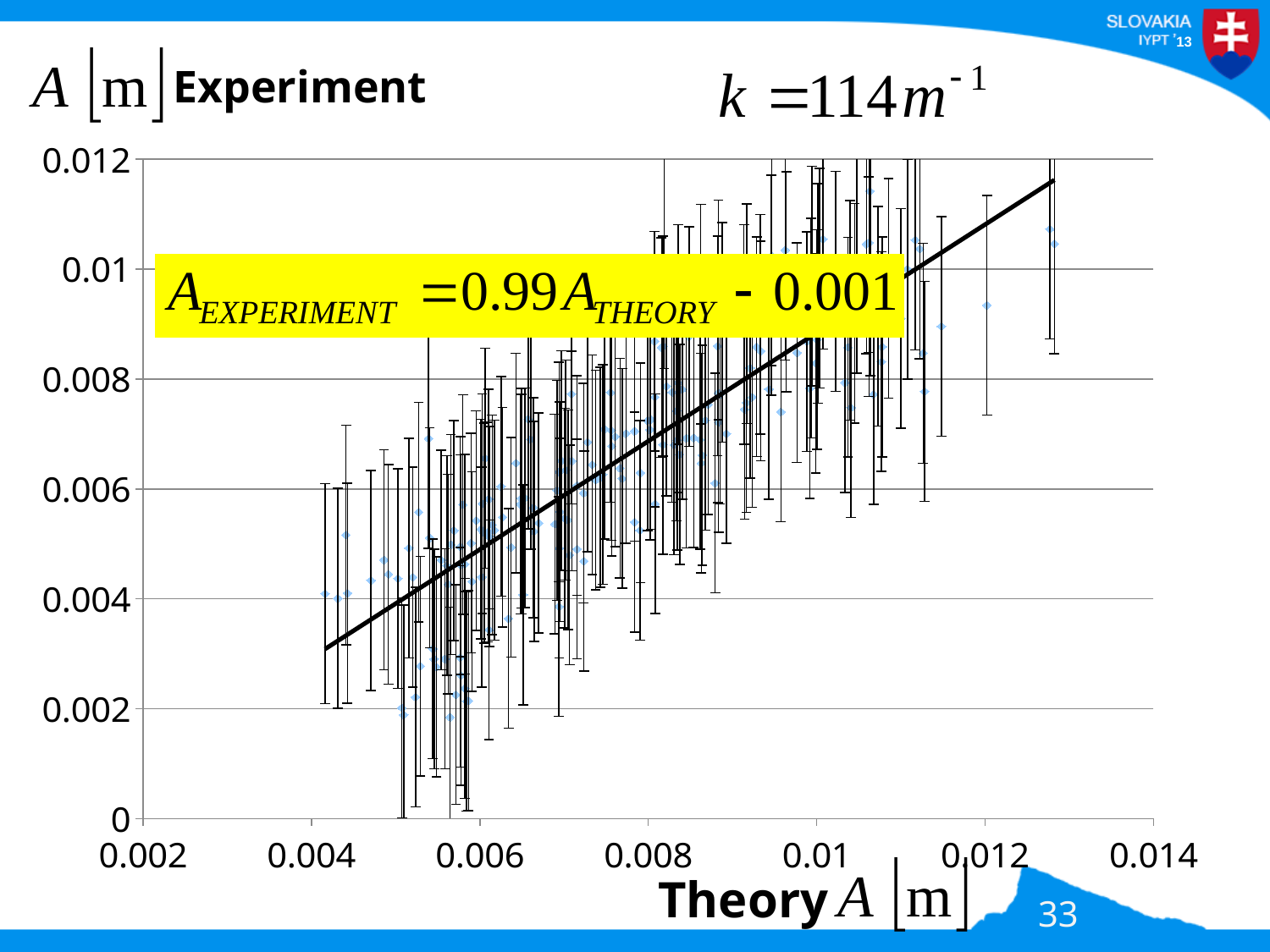
What is the label of the x axis? Theory A [m] What is the spacing between consecutive tick marks on the y axis? 0.002 What is the lowest tick value shown on the x axis? 0.002 What kind of chart is shown on the slide? scatter chart What is the highest tick value shown on the y axis? 0.012 Do the experimental values generally rise or fall as the theory value A increases along the x axis? rise According to the fitted equation on the chart, what is the slope coefficient multiplying A_THEORY? 0.99 What is the label of the y axis? A [m] Experiment Are the experimental values plotted near theory A = 0.004 greater or less than 0.006? less According to the fitted equation on the chart, what is the intercept term? -0.001 What value of k is stated above the chart? 114 m^-1 What is the highest tick value shown on the x axis? 0.014